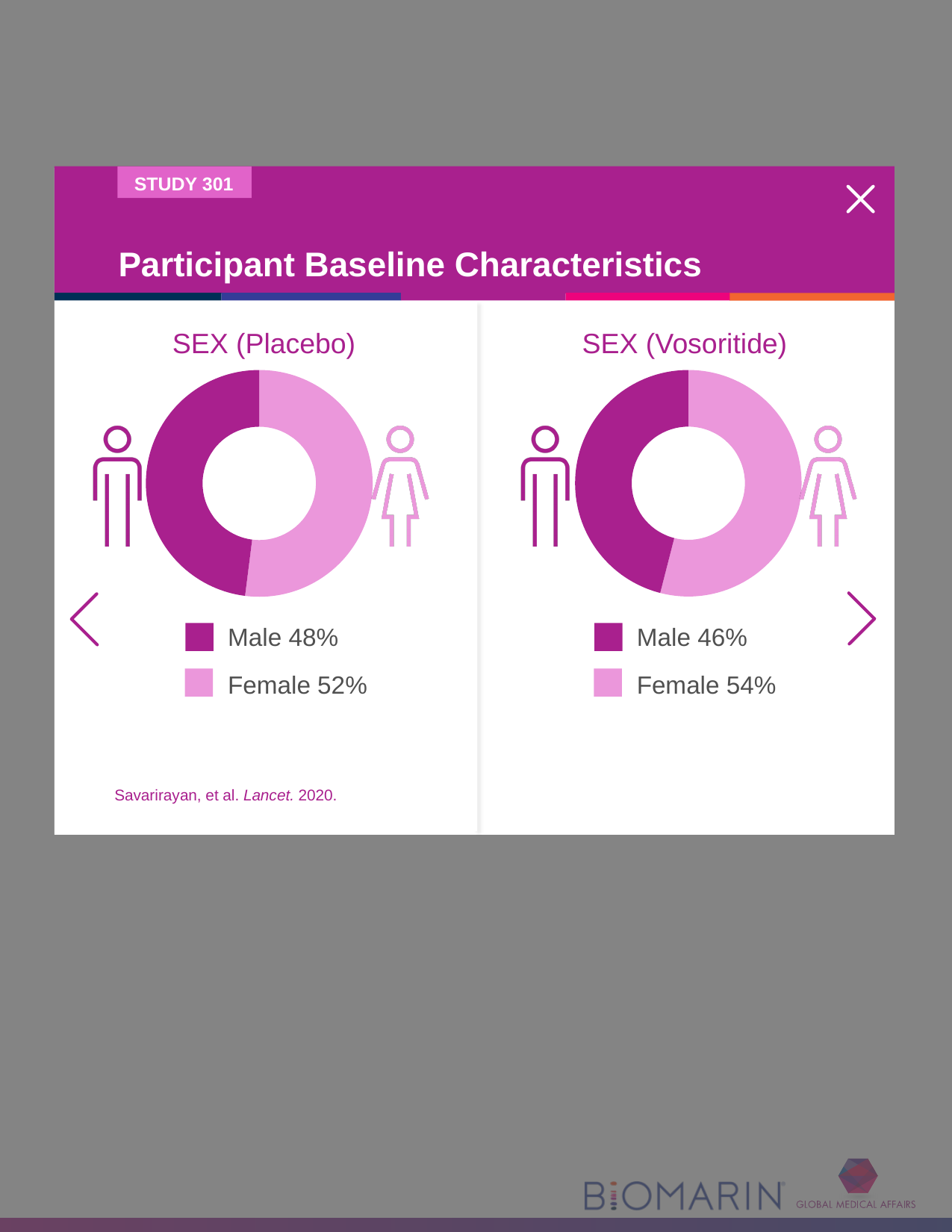
What is the title of the chart on the right side of the slide? SEX (Vosoritide) In the SEX (Placebo) chart, what is the difference between the female and male percentages? 4% In the SEX (Placebo) chart, which category has the larger share? Female In the SEX (Placebo) chart, what percentage of participants are male? 48% What kind of chart is the SEX (Placebo) chart? Donut (pie) chart How many categories does the SEX (Vosoritide) chart show? 2 In the SEX (Vosoritide) chart, what percentage of participants are female? 54% In the SEX (Vosoritide) chart, what is the difference between the female and male percentages? 8% In the SEX (Placebo) chart, what percentage of participants are female? 52% In the SEX (Vosoritide) chart, what percentage of participants are male? 46% Is the male share larger in the SEX (Placebo) chart or the SEX (Vosoritide) chart? SEX (Placebo) In the SEX (Vosoritide) chart, which category has the smaller share? Male